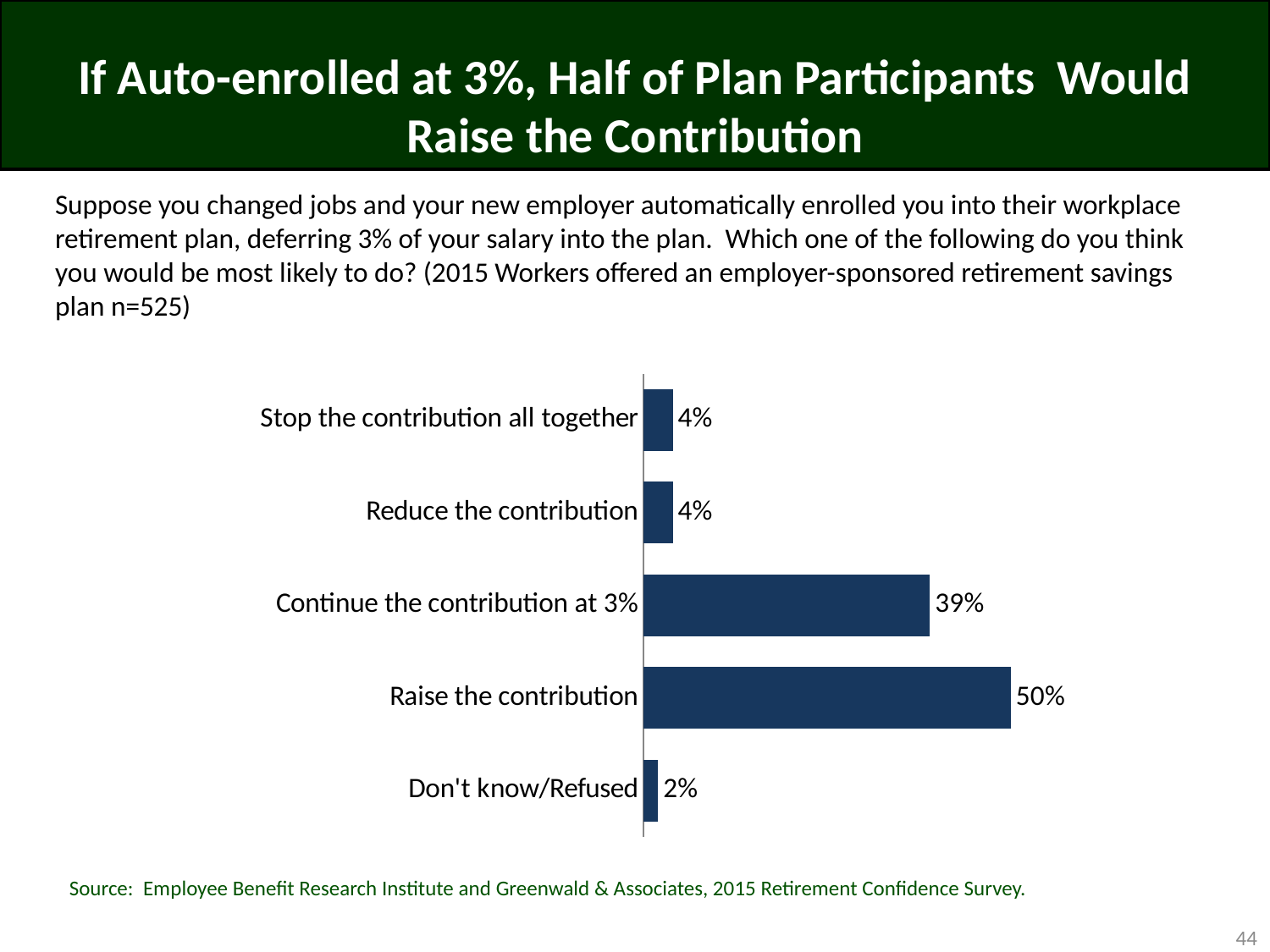
What type of chart is shown on the slide? Bar chart How many response categories are shown in the chart? 5 What percentage of respondents said they would stop the contribution all together? 4% What is the combined percentage for 'Stop the contribution all together' and 'Reduce the contribution'? 8% What percentage of respondents said they would continue the contribution at 3%? 39% What percentage of respondents said they would raise the contribution? 50% What is the difference in percentage points between 'Raise the contribution' and 'Continue the contribution at 3%'? 11 percentage points What percentage of respondents answered Don't know/Refused? 2% Which response has the lowest percentage? Don't know/Refused Which response has the highest percentage? Raise the contribution What is the sample size (n) stated for the survey question on the slide? 525 Which is larger: the percentage for 'Reduce the contribution' or for 'Don't know/Refused'? Reduce the contribution